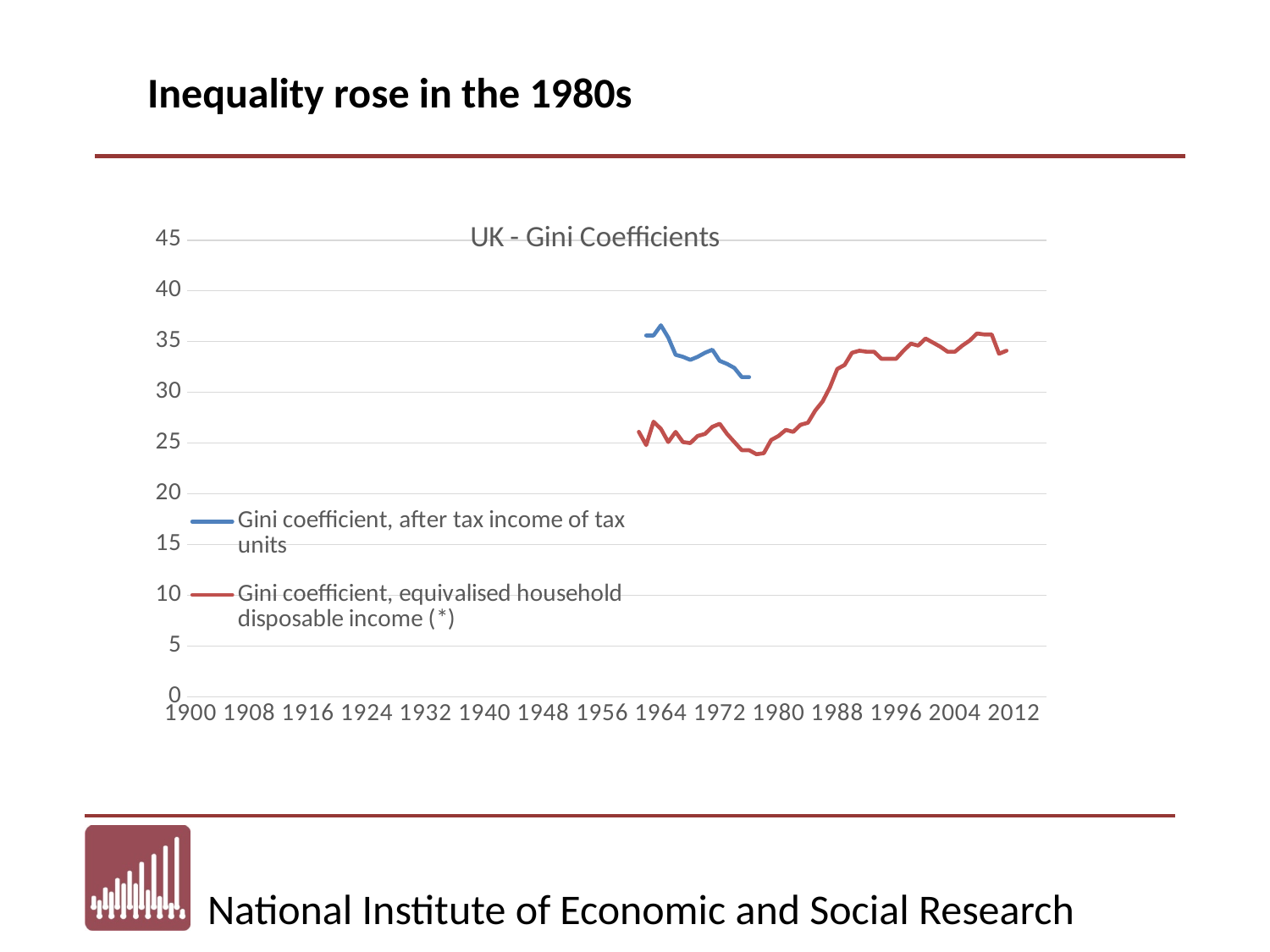
Does the blue series (after tax income of tax units) generally rise or fall between 1964 and 1976? fall Is the value of the blue series (after tax income of tax units) around 1976 greater or less than 35? less Is the value of the red series (equivalised household disposable income) around 1964 greater or less than 30? less Around 1964, which series has the higher value: the blue series (after tax income of tax units) or the red series (equivalised household disposable income)? the blue series (after tax income of tax units) How many series does the chart's legend list? 2 Does the red series (equivalised household disposable income) rise or fall between 1980 and 1990? rise What is the title of the chart? UK - Gini Coefficients Is the value of the red series (equivalised household disposable income) around 1988 greater or less than 30? greater What kind of chart is shown on the slide? line chart Which series is drawn in red? Gini coefficient, equivalised household disposable income (*)